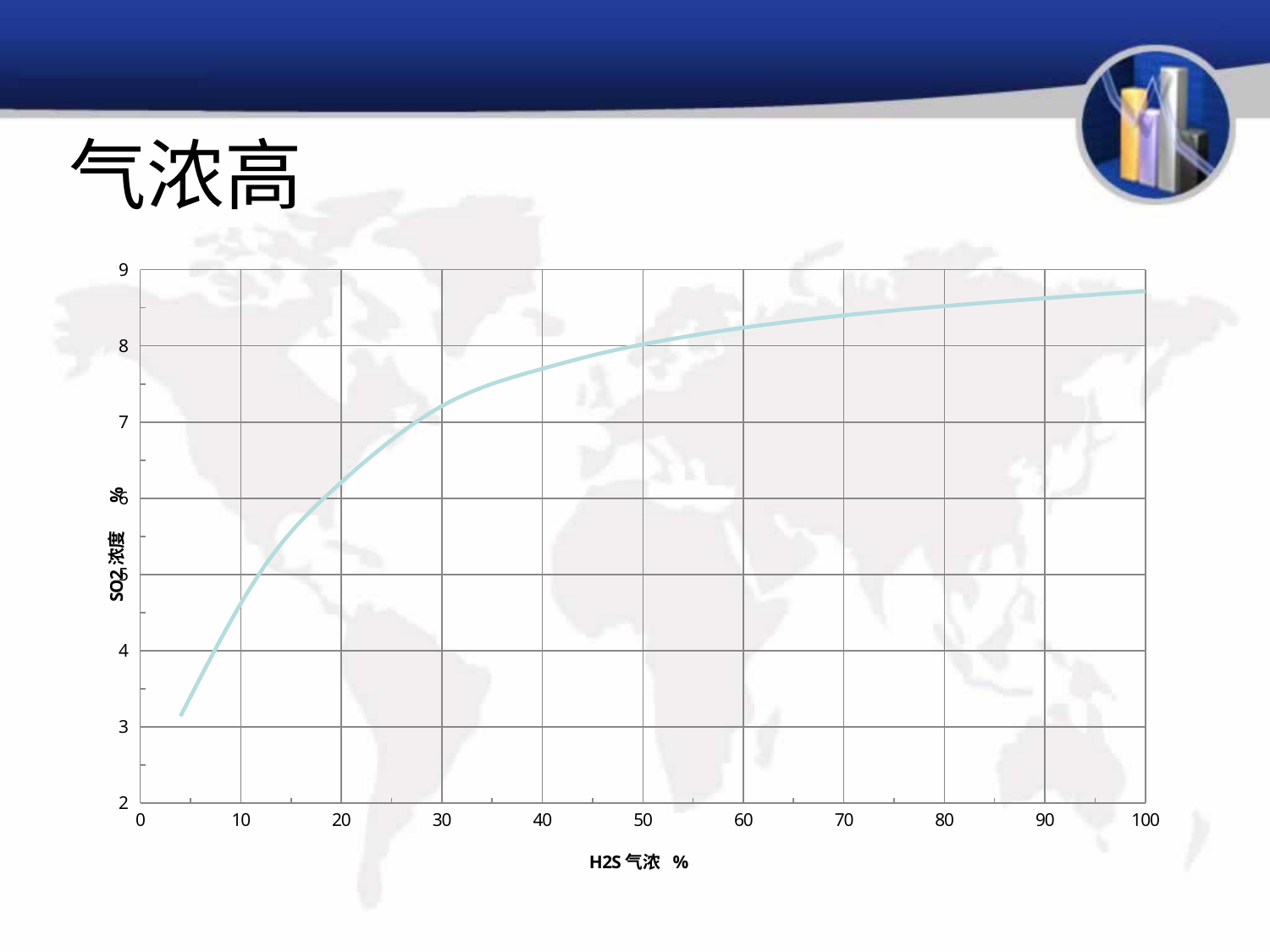
Is the SO2 concentration at an H2S concentration of 30% greater or less than 7? greater Is the SO2 concentration at an H2S concentration of 20% greater or less than 6? greater Is the SO2 concentration at an H2S concentration of 70% greater or less than 8? greater What kind of chart is shown on the slide? line chart What is the label of the y axis of the chart? SO2 浓度 % Is the SO2 concentration at an H2S concentration of 20% greater or less than the value at 60%? less Does the SO2 concentration rise or fall as the H2S concentration increases along the x axis? rise What is the label of the x axis of the chart? H2S 气浓 %